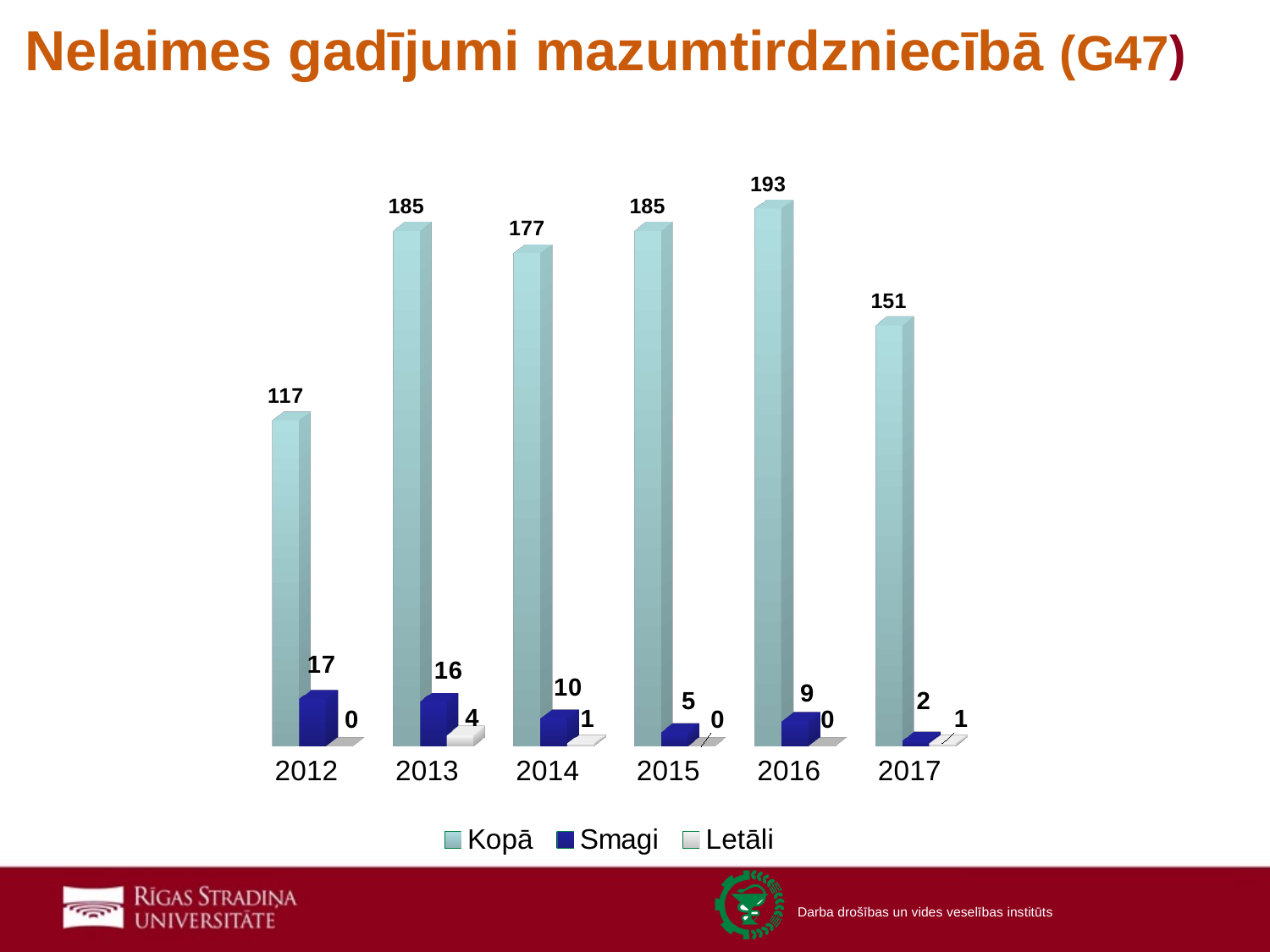
What kind of chart is shown on the slide? Bar chart Which is larger, the Smagi value for 2014 or for 2015? 2014 What are the three series listed in the legend? Kopā, Smagi, Letāli What is the difference between the Kopā values for 2016 and 2017? 42 How many years are shown on the x axis? 6 Does the Smagi value rise or fall from 2012 to 2015? Fall Which year has the lowest Kopā value? 2012 How many series does the legend list? 3 What is the Smagi value for 2012? 17 What is the Kopā value for 2016? 193 Which year has the highest Kopā value? 2016 What is the Letāli value for 2013? 4